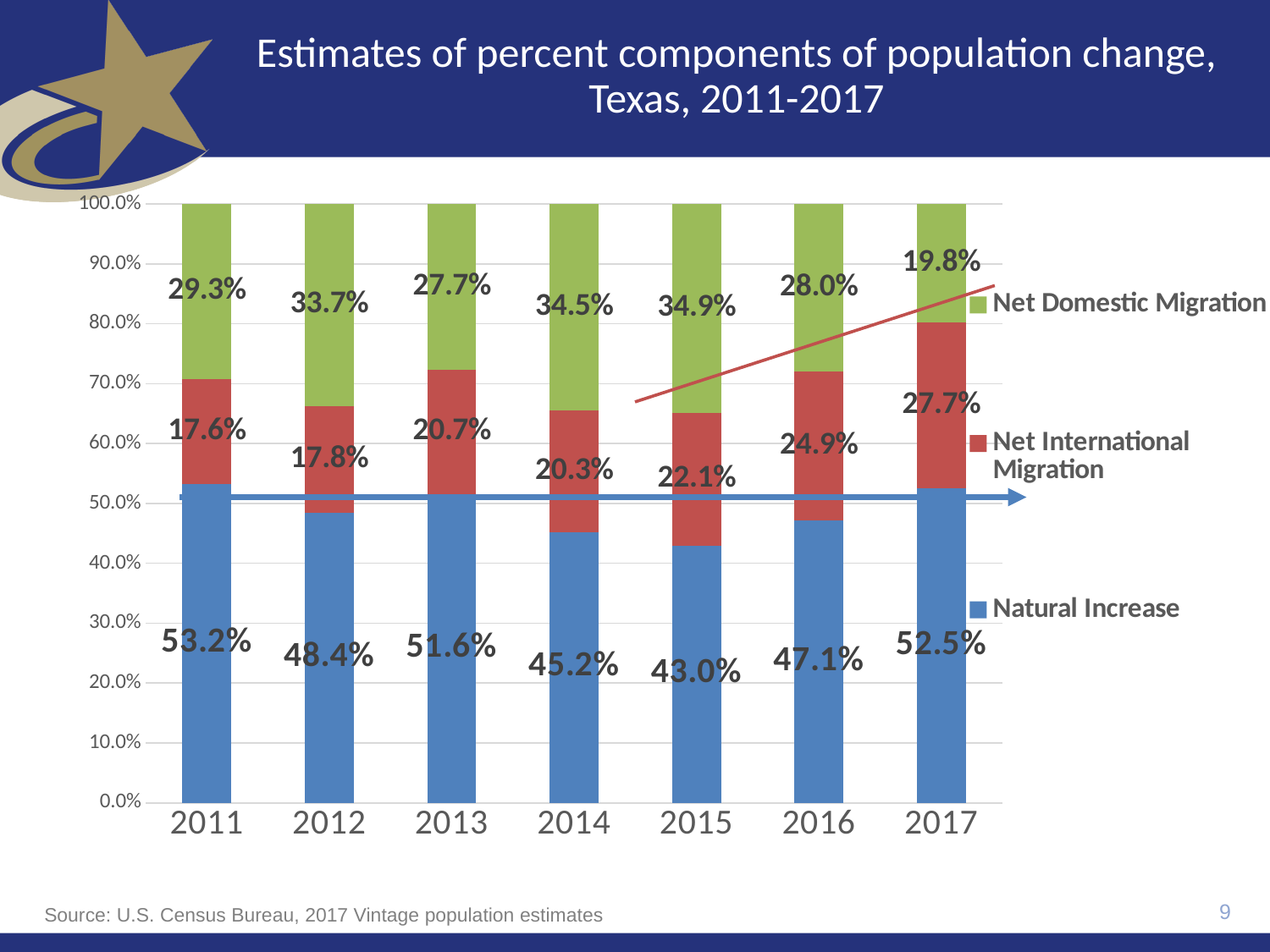
How many years are shown on the x axis? 7 What is the Net Domestic Migration value for 2015? 34.9% Which is larger, the Net Domestic Migration value for 2012 or for 2016? 2012 What is the Natural Increase value for 2011? 53.2% Which year has the highest Net International Migration value? 2017 Which year has the lowest Net Domestic Migration value? 2017 How many series does the legend list? 3 What is the Net International Migration value for 2017? 27.7% Does the Net International Migration value rise or fall from 2013 to 2017? Rise Which year has the lowest Natural Increase value? 2015 What is the difference between the Natural Increase values for 2011 and 2015? 10.2% What kind of chart is shown on the slide? Stacked bar chart